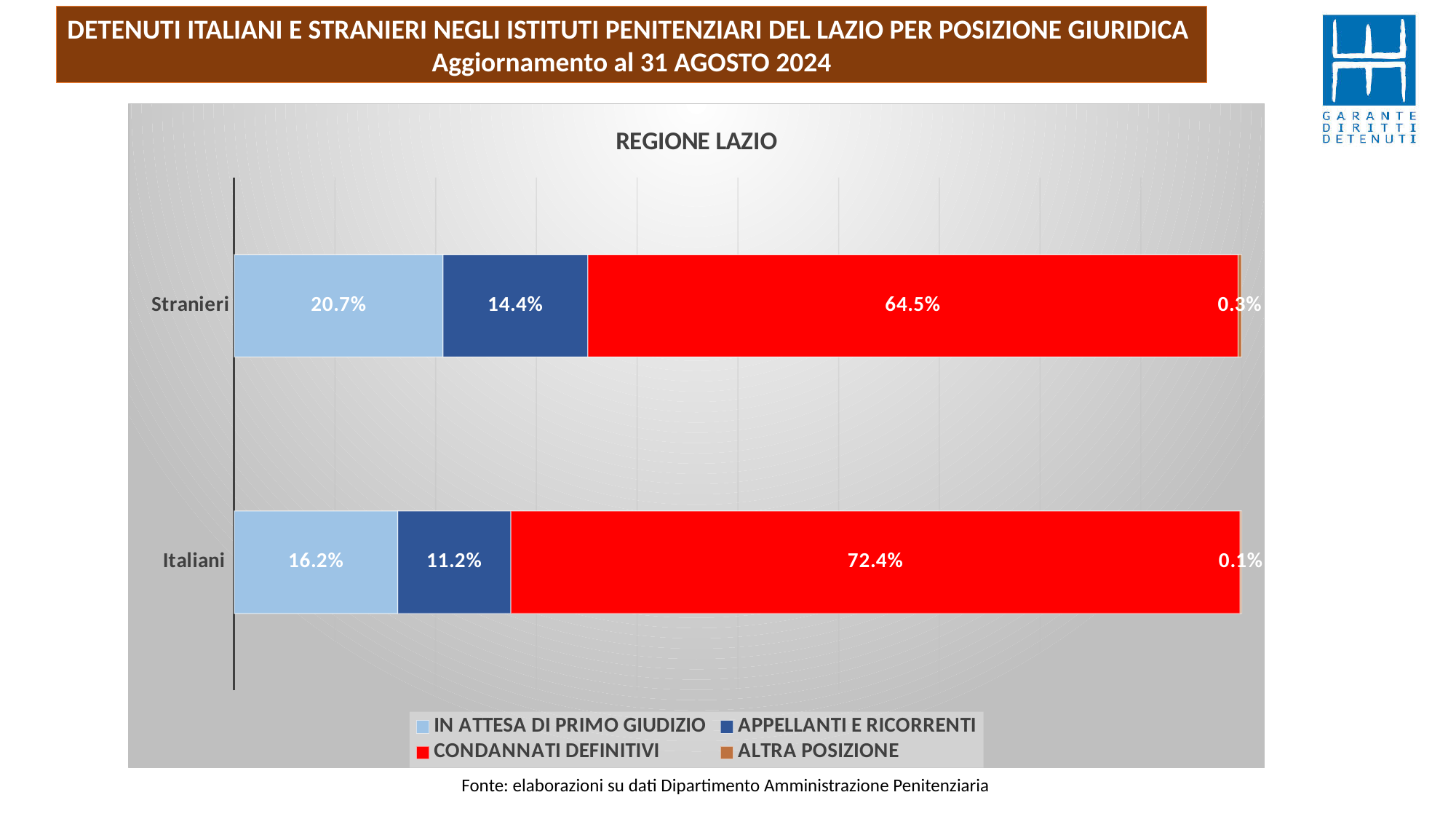
What is the value for ALTRA POSIZIONE among Italiani? 0.1% Which series has the highest value in the Italiani bar? CONDANNATI DEFINITIVI What kind of chart is shown on the slide? Stacked bar chart Which series has the lowest value in the Stranieri bar? ALTRA POSIZIONE What is the value for APPELLANTI E RICORRENTI among Stranieri? 14.4% Which group has the larger share of IN ATTESA DI PRIMO GIUDIZIO, Stranieri or Italiani? Stranieri How many series does the legend list? 4 What percentage of Stranieri are IN ATTESA DI PRIMO GIUDIZIO? 20.7% What percentage of Italiani are CONDANNATI DEFINITIVI? 72.4% What is the difference between the CONDANNATI DEFINITIVI share for Italiani and for Stranieri? 7.9 percentage points How many categories (groups) are shown on the chart? 2 What colour represents CONDANNATI DEFINITIVI in the chart? Red